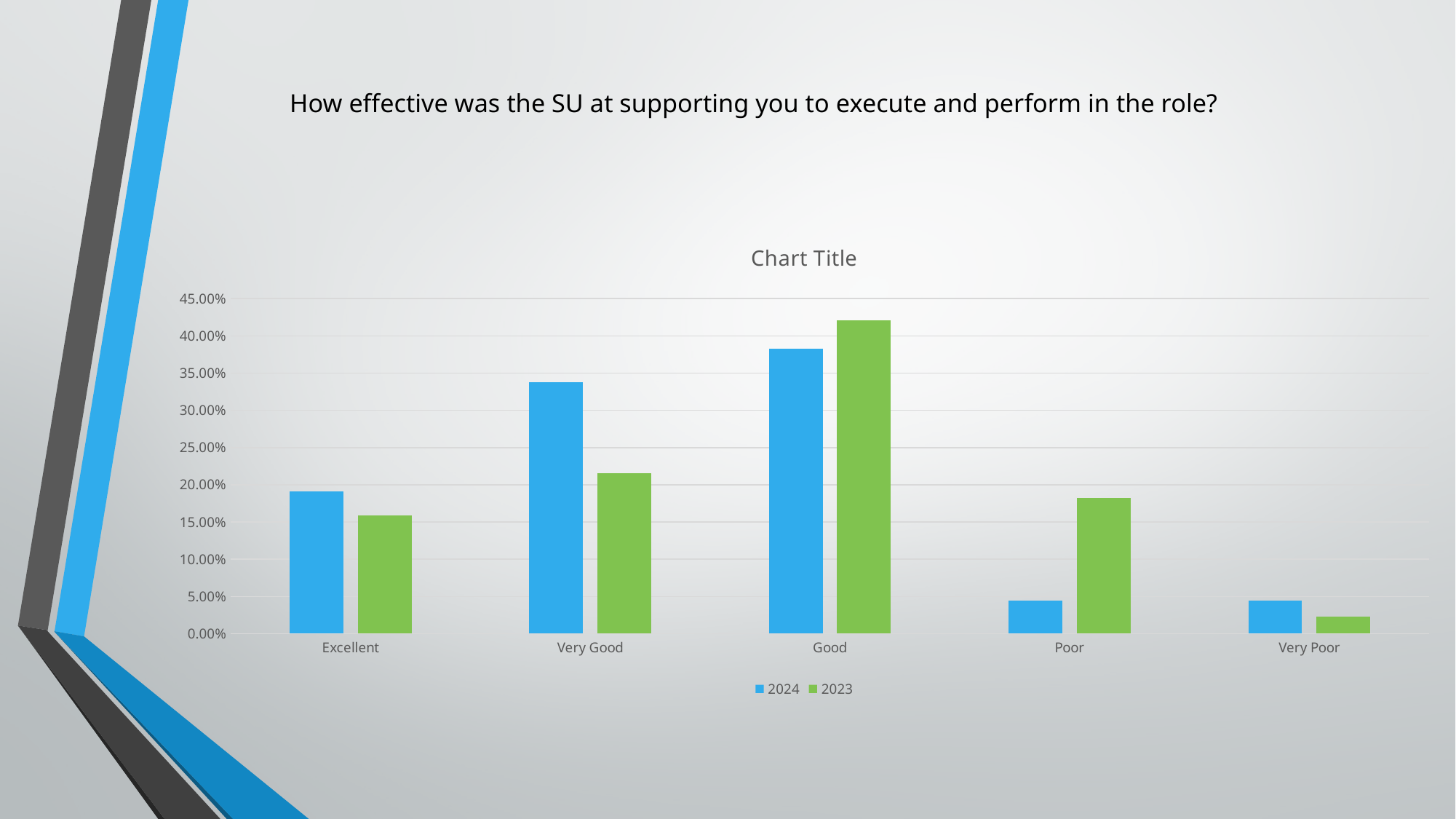
For the Very Good category, which series has the larger value, 2024 or 2023? 2024 Which category has the highest value for the 2023 series? Good Is the 2024 value for Very Good greater or less than 30.00%? greater For the Poor category, which series has the larger value, 2024 or 2023? 2023 How many series does the legend list? 2 Which category has the lowest value for the 2023 series? Very Poor Is the 2023 value for Good greater or less than 40.00%? greater Is the 2023 value for Poor greater or less than 20.00%? less How many categories are shown on the x axis? 5 What colour are the bars for the 2023 series? green Which category has the highest value for the 2024 series? Good What kind of chart is shown on the slide? bar chart